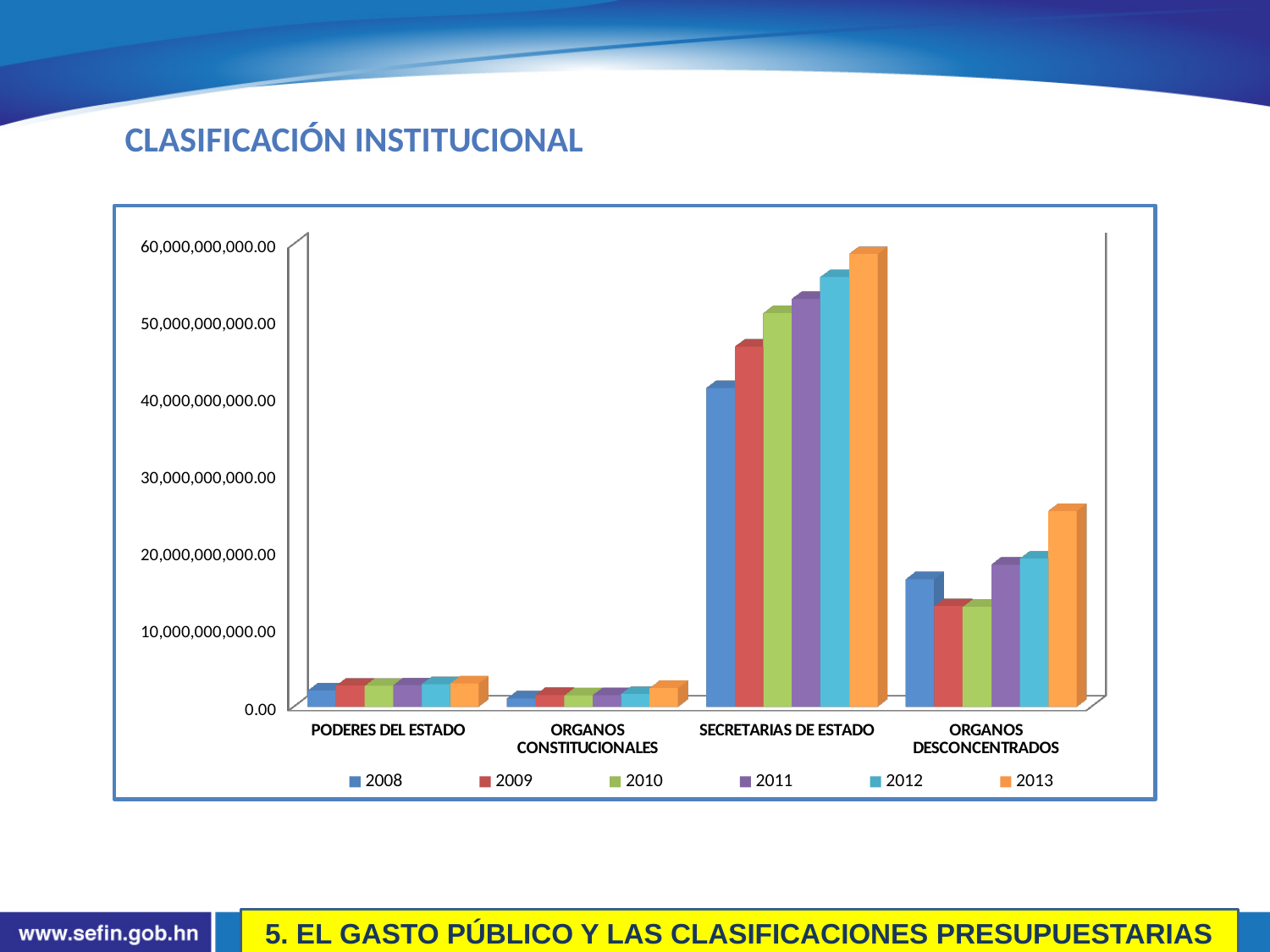
Is the 2013 value for SECRETARIAS DE ESTADO greater or less than 50,000,000,000.00? greater For ORGANOS DESCONCENTRADOS, which is larger: the 2008 value or the 2009 value? 2008 Is the 2009 value for ORGANOS DESCONCENTRADOS greater or less than 20,000,000,000.00? less What kind of chart is shown on the slide? Bar chart Which category has the highest values in the chart? SECRETARIAS DE ESTADO How many series does the chart's legend list? 6 How many categories are shown on the x axis of the chart? 4 Which year does the orange series in the legend represent? 2013 Which category has the lowest values in the chart? ORGANOS CONSTITUCIONALES Is the 2008 value for SECRETARIAS DE ESTADO greater or less than 50,000,000,000.00? less Do the values for SECRETARIAS DE ESTADO rise or fall from 2008 to 2013? Rise